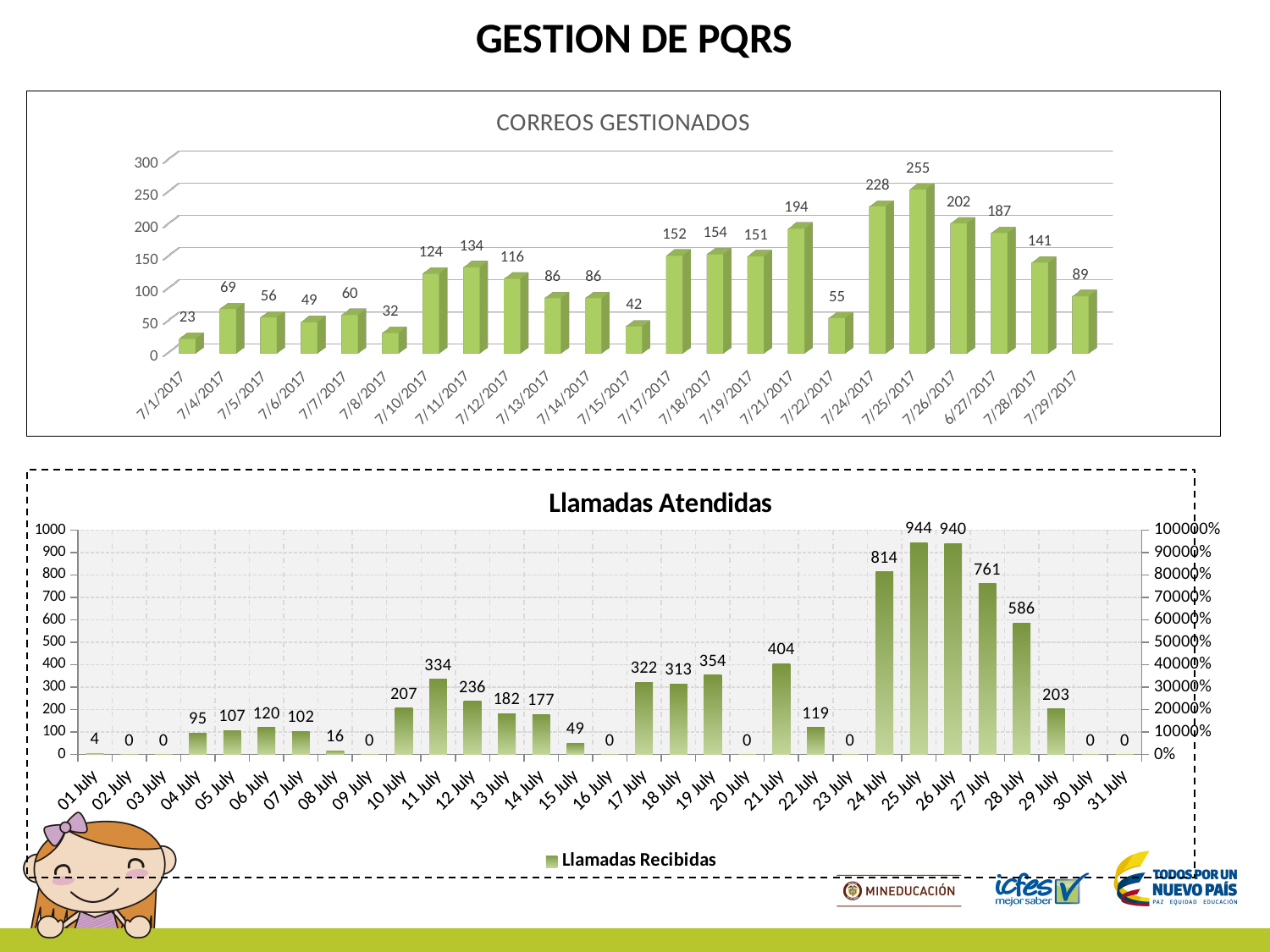
In the CORREOS GESTIONADOS chart, which date has the highest value? 7/25/2017 In the CORREOS GESTIONADOS chart, what is the difference between the values for 7/24/2017 and 7/22/2017? 173 What is the legend entry in the Llamadas Atendidas chart? Llamadas Recibidas How many dates are shown on the x axis of the CORREOS GESTIONADOS chart? 23 In the Llamadas Atendidas chart, which day has the highest value? 25 July What kind of chart is the Llamadas Atendidas chart? bar chart In the CORREOS GESTIONADOS chart, what is the value for 7/25/2017? 255 How many series does the legend of the Llamadas Atendidas chart list? 1 In the CORREOS GESTIONADOS chart, which is larger, the value for 7/11/2017 or the value for 7/12/2017? 7/11/2017 In the Llamadas Atendidas chart, what is the value for 24 July? 814 In the Llamadas Atendidas chart, what is the difference between the values for 21 July and 22 July? 285 In the CORREOS GESTIONADOS chart, which date has the lowest value? 7/1/2017